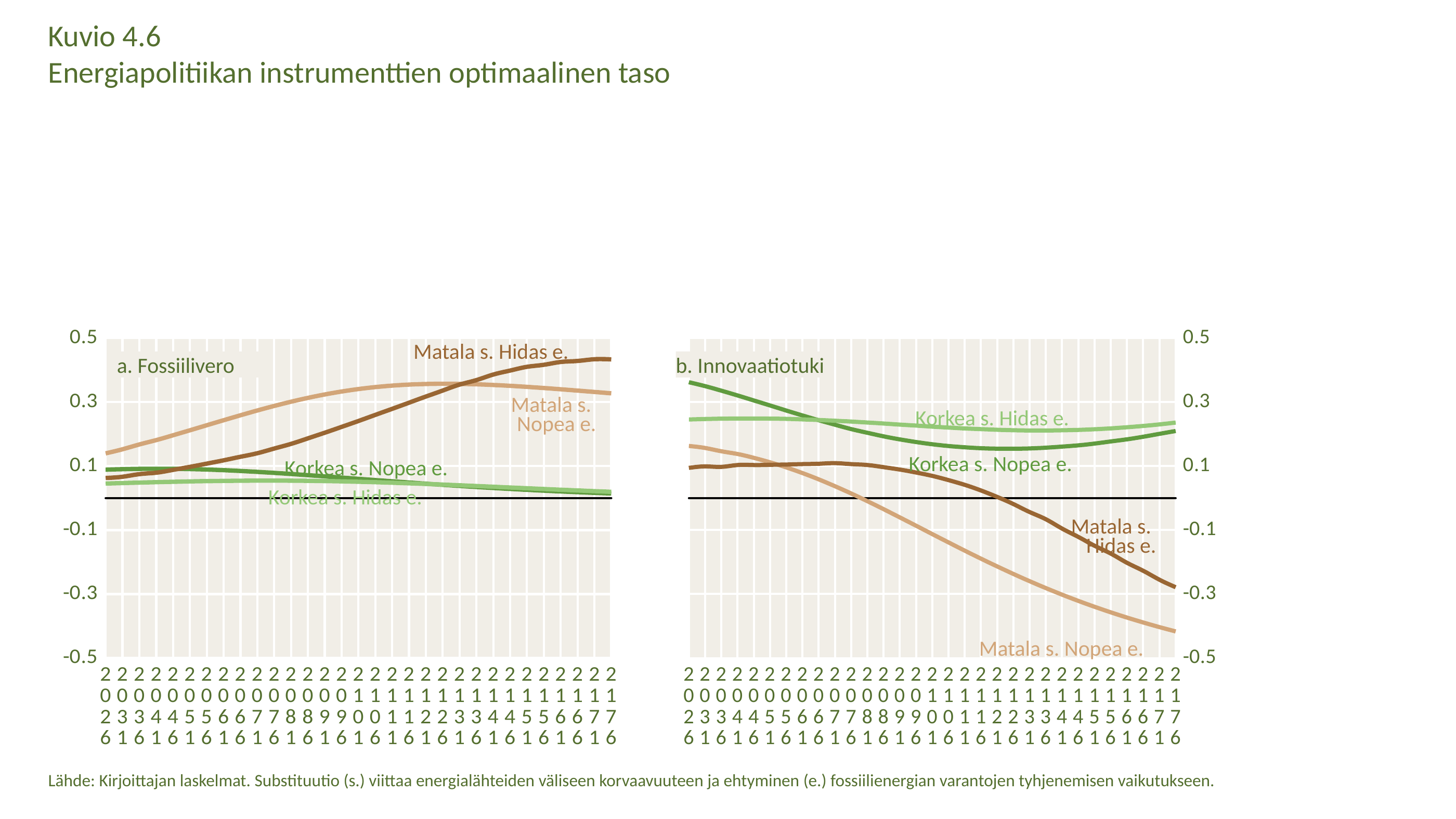
In panel b. Innovaatiotuki, which is higher in 2176: Korkea s. Hidas e. or Matala s. Hidas e.? Korkea s. Hidas e. In panel b. Innovaatiotuki, which series has the lowest value in 2176? Matala s. Nopea e. In panel a. Fossiilivero, does the Matala s. Hidas e. line rise or fall from 2026 to 2176? rise In panel b. Innovaatiotuki, does the Matala s. Nopea e. line rise or fall from 2026 to 2176? fall What kind of chart is used in panel a. Fossiilivero? line chart What is the title of the left-hand panel? a. Fossiilivero In panel b. Innovaatiotuki, is the value for Korkea s. Nopea e. in 2026 greater or less than 0.3? greater In panel a. Fossiilivero, which is higher in 2176: Matala s. Hidas e. or Matala s. Nopea e.? Matala s. Hidas e. In panel a. Fossiilivero, is the value for Matala s. Hidas e. in 2176 greater or less than 0.3? greater In panel b. Innovaatiotuki, which series has the highest value in 2026? Korkea s. Nopea e. How many series are plotted in panel b. Innovaatiotuki? 4 In panel b. Innovaatiotuki, is the value for Matala s. Nopea e. in 2176 greater or less than -0.3? less